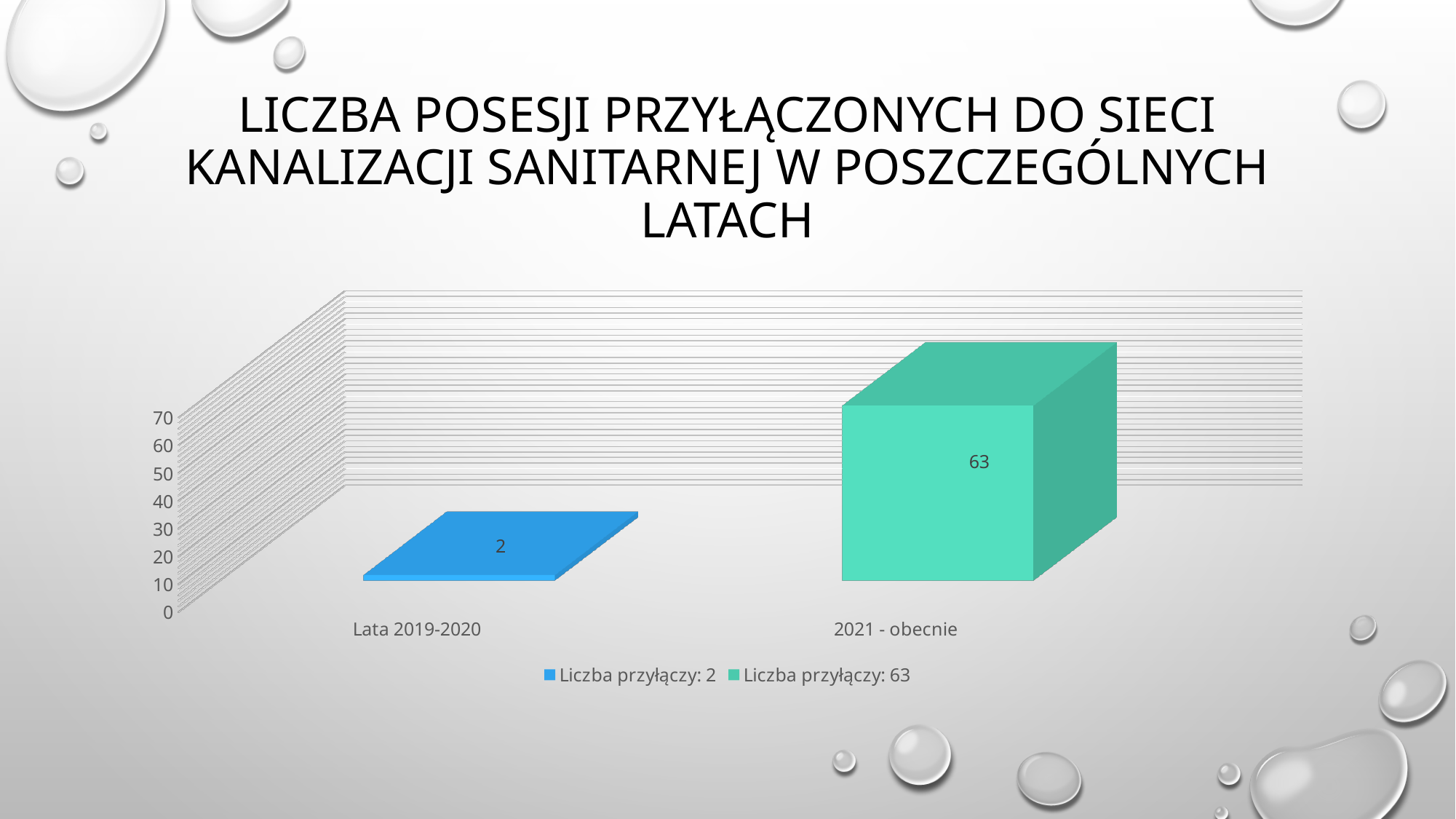
What is the value for Lata 2019-2020? 2 Which category has the lowest value? Lata 2019-2020 Which is larger, the value for Lata 2019-2020 or the value for 2021 - obecnie? 2021 - obecnie What is the highest value shown on the vertical axis? 70 Which category has the highest value? 2021 - obecnie What is the difference between the value for 2021 - obecnie and the value for Lata 2019-2020? 61 What is the value for 2021 - obecnie? 63 How many entries does the legend list? 2 Do the values rise or fall from Lata 2019-2020 to 2021 - obecnie? rise How many categories are shown on the x axis? 2 What kind of chart is shown on the slide? bar chart Is the value for 2021 - obecnie greater or less than 50? greater